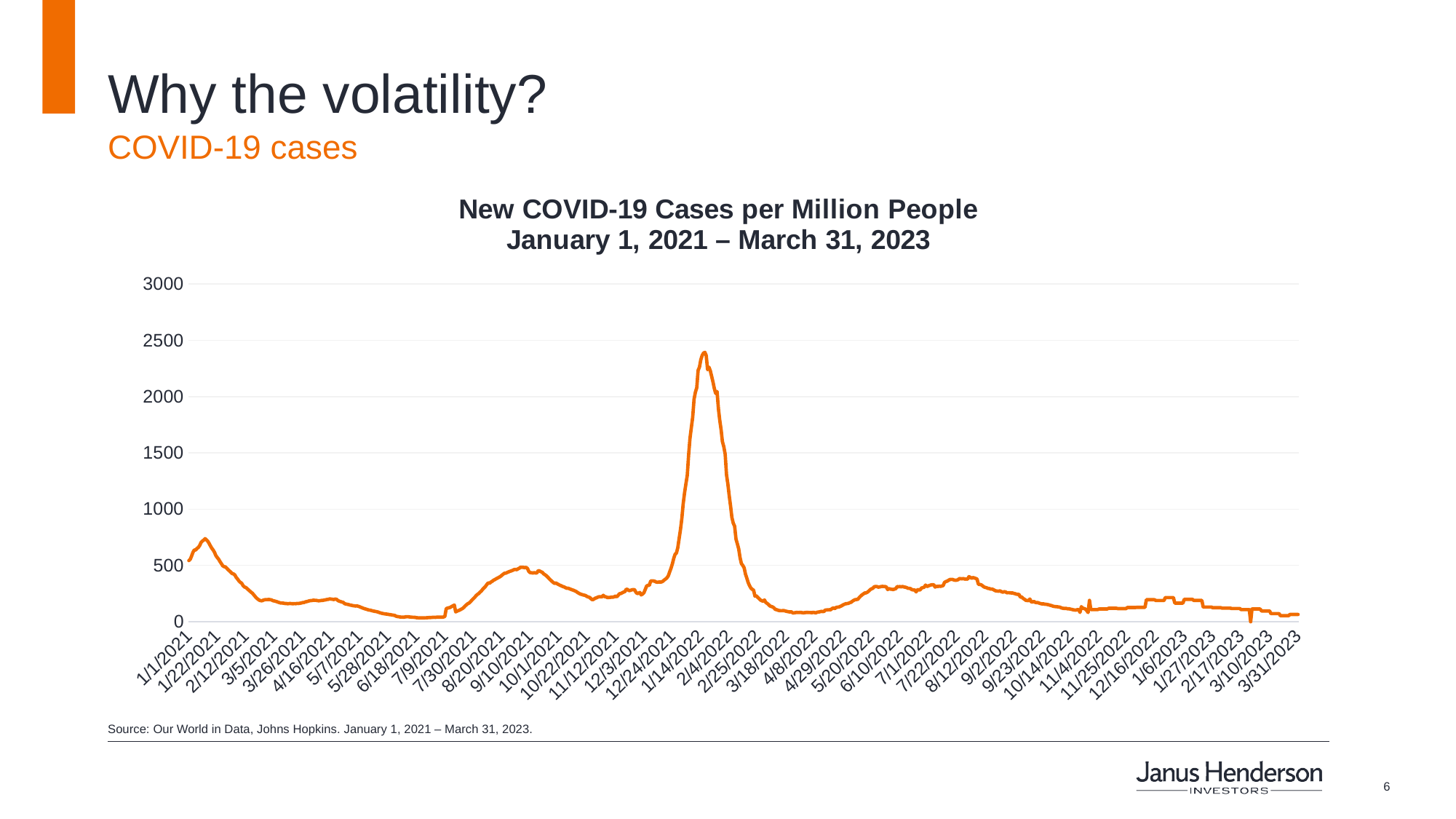
Does the line rise or fall between 12/24/2021 and 1/14/2022? Rise What kind of chart is shown on the slide? Line chart Does the line rise or fall between 2/4/2022 and 3/18/2022? Fall What is the title of the chart? New COVID-19 Cases per Million People January 1, 2021 – March 31, 2023 Around which x-axis date does the line reach its highest point? 1/14/2022 Is the value on 6/18/2021 greater or less than 500? less Is the peak value of the line in early 2022 greater or less than 2500? less Is the value on 7/22/2022 greater or less than 1000? less What is the highest value shown on the y-axis of the chart? 3000